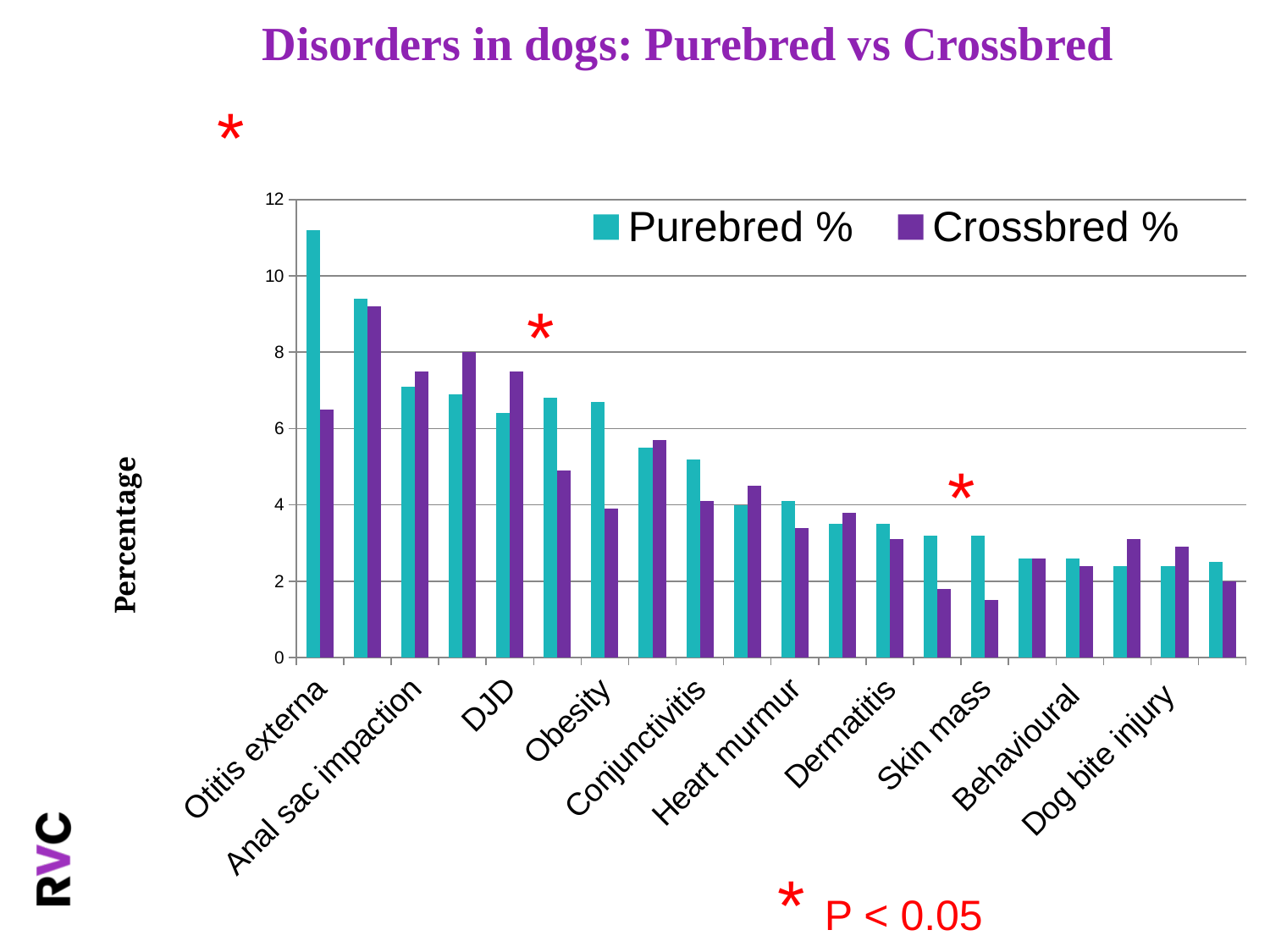
For Otitis externa, which is larger: the Purebred % or the Crossbred % value? Purebred % For Obesity, which is larger: the Purebred % or the Crossbred % value? Purebred % How many series does the legend list? 2 What kind of chart is shown on the slide? bar chart What is the label of the y axis? Percentage What is the title of the chart? Disorders in dogs: Purebred vs Crossbred Is the Crossbred % value for Otitis externa greater or less than 6? greater What are the two series named in the legend? Purebred % and Crossbred % Is the Purebred % value for Otitis externa greater or less than 10? greater Which disorder has the highest Purebred % value? Otitis externa Do the Purebred % values generally rise or fall moving from left to right along the x axis? fall